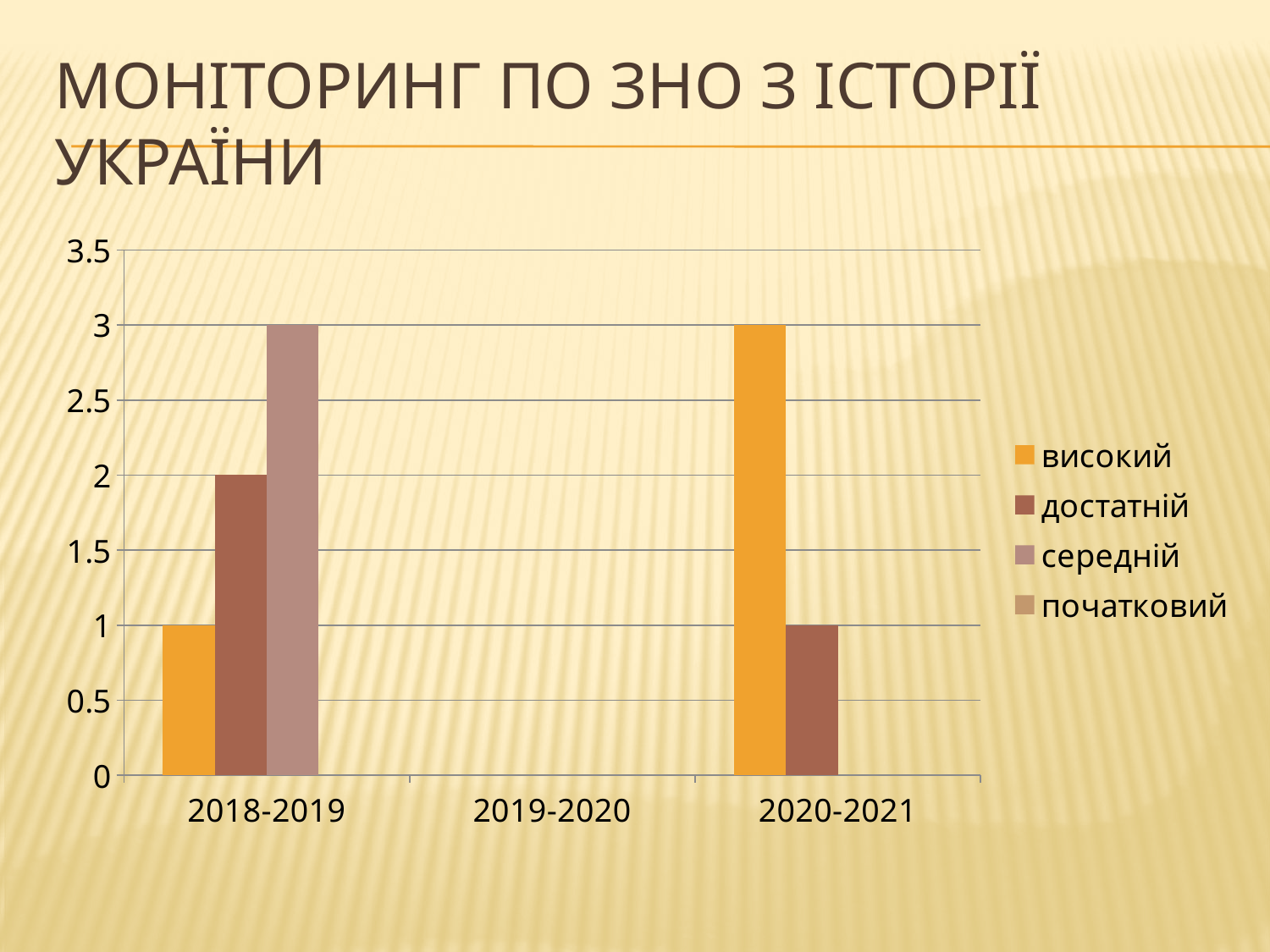
What kind of chart is shown on the slide? bar chart What is the value for високий in 2018-2019? 1 How many categories are shown on the x axis? 3 How many series does the legend list? 4 What is the difference between достатній in 2018-2019 and достатній in 2020-2021? 1 What is the value for достатній in 2020-2021? 1 Which category on the x axis has no bars plotted? 2019-2020 What is the value for достатній in 2018-2019? 2 What is the value for високий in 2020-2021? 3 Which is larger, високий in 2018-2019 or високий in 2020-2021? високий in 2020-2021 Which series has the highest value in 2018-2019? середній What is the value for середній in 2018-2019? 3